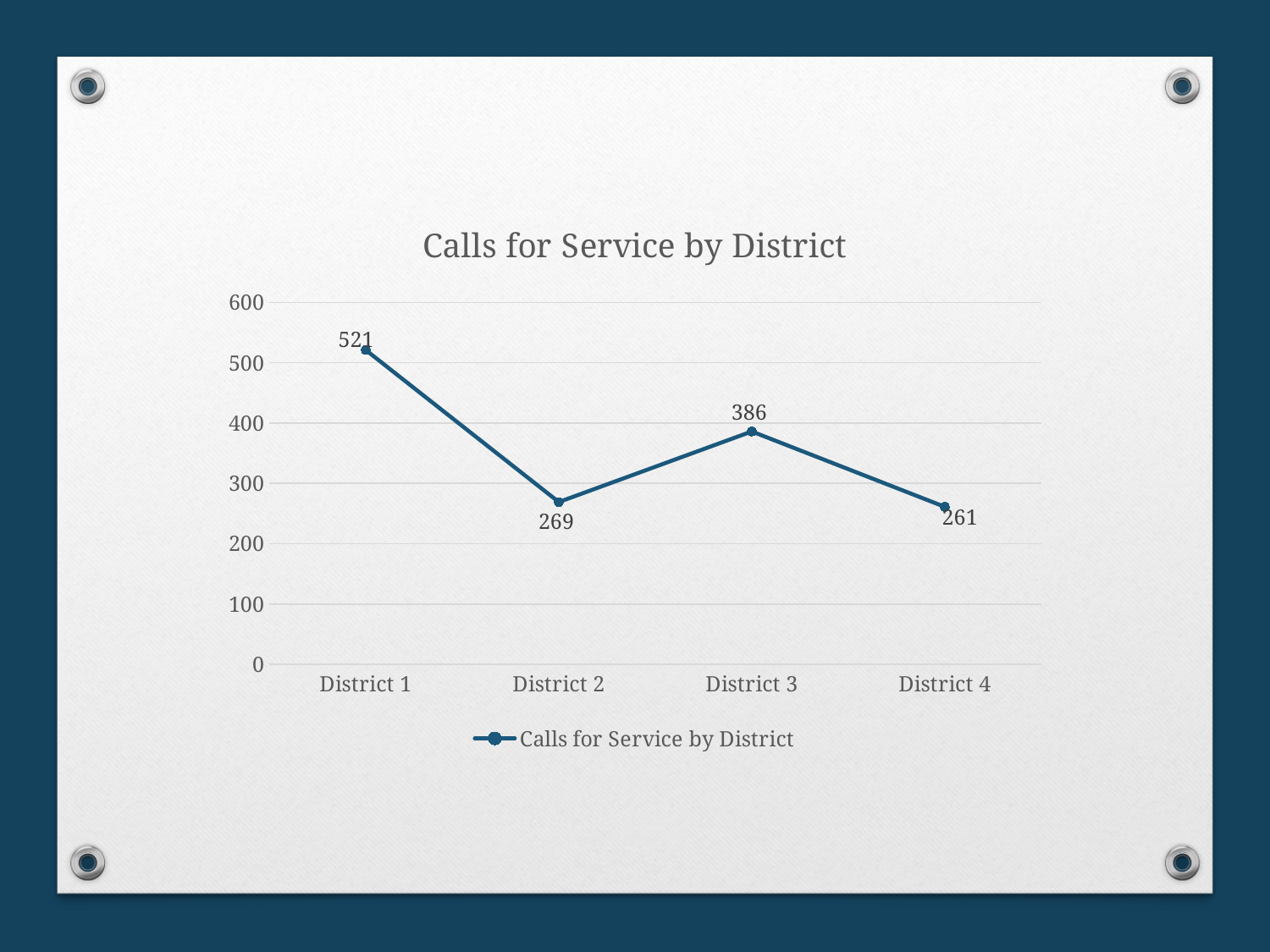
What is the value for District 3? 386 Which district has the lowest number of calls for service? District 4 What is the value for District 4? 261 What is the title of the chart? Calls for Service by District Which is larger, the value for District 2 or District 3? District 3 Is the value for District 2 greater or less than 300? less How many districts are plotted on the chart? 4 What is the difference between the values for District 1 and District 2? 252 What is the value for District 1? 521 What is the difference between the values for District 3 and District 4? 125 Which district has the highest number of calls for service? District 1 What kind of chart is shown on the slide? line chart